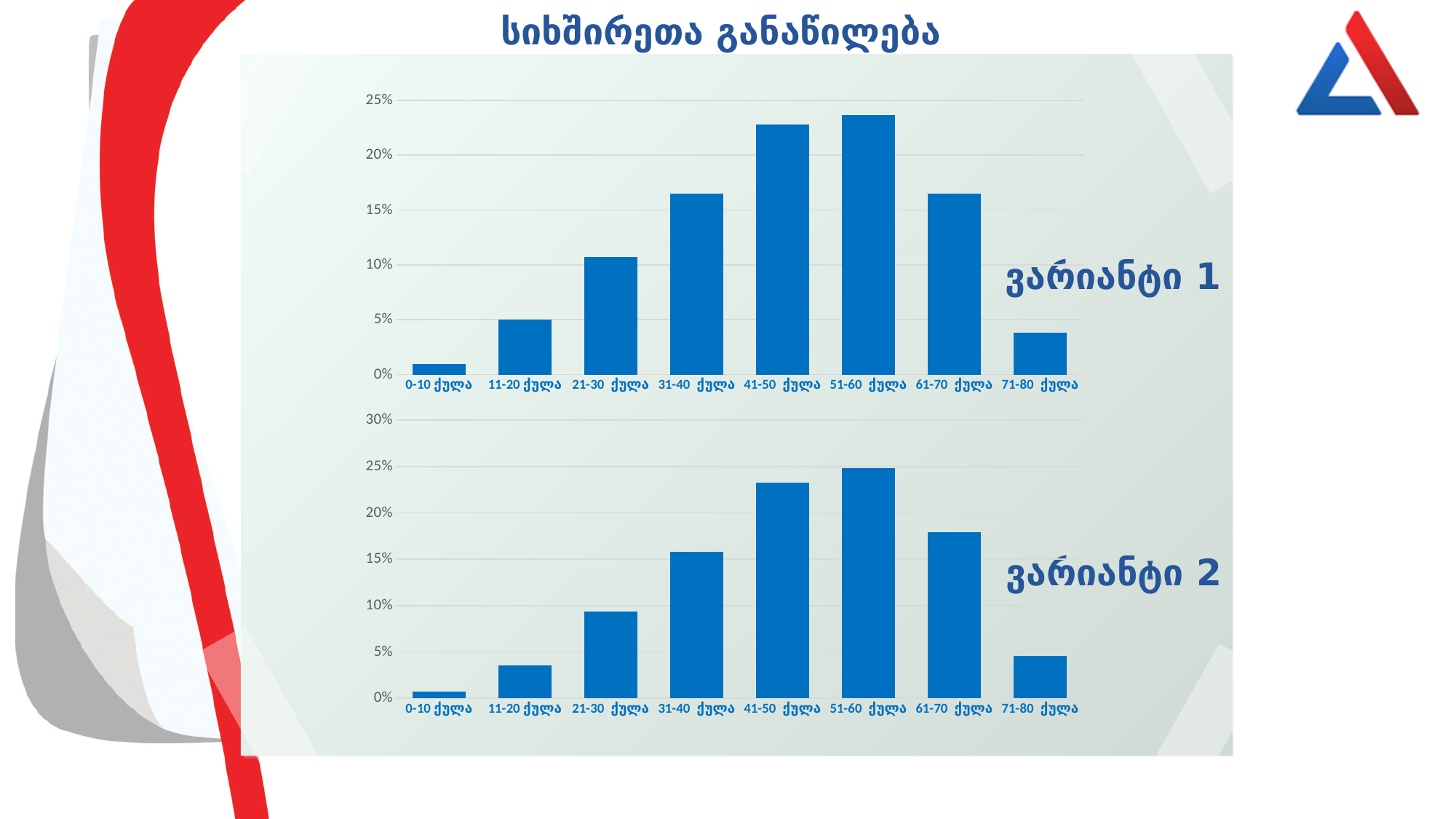
In the top chart (ვარიანტი 1), which category has the lowest value? 0-10 ქულა How many score categories are shown on the x axis of the bottom chart (ვარიანტი 2)? 8 What kind of chart is the top chart (ვარიანტი 1)? bar chart In the top chart (ვარიანტი 1), is the value for 41-50 ქულა greater or less than 20%? greater In the top chart (ვარიანტი 1), which category has the highest value? 51-60 ქულა In the bottom chart (ვარიანტი 2), which is larger: the value for 41-50 ქულა or the value for 61-70 ქულა? 41-50 ქულა In the top chart (ვარიანტი 1), is the value for 71-80 ქულა greater or less than 5%? less In the bottom chart (ვარიანტი 2), is the value for 11-20 ქულა greater or less than 5%? less What is the title of the slide above the two charts? სიხშირეთა განაწილება In the bottom chart (ვარიანტი 2), which category has the highest value? 51-60 ქულა In the bottom chart (ვარიანტი 2), which category has the lowest value? 0-10 ქულა